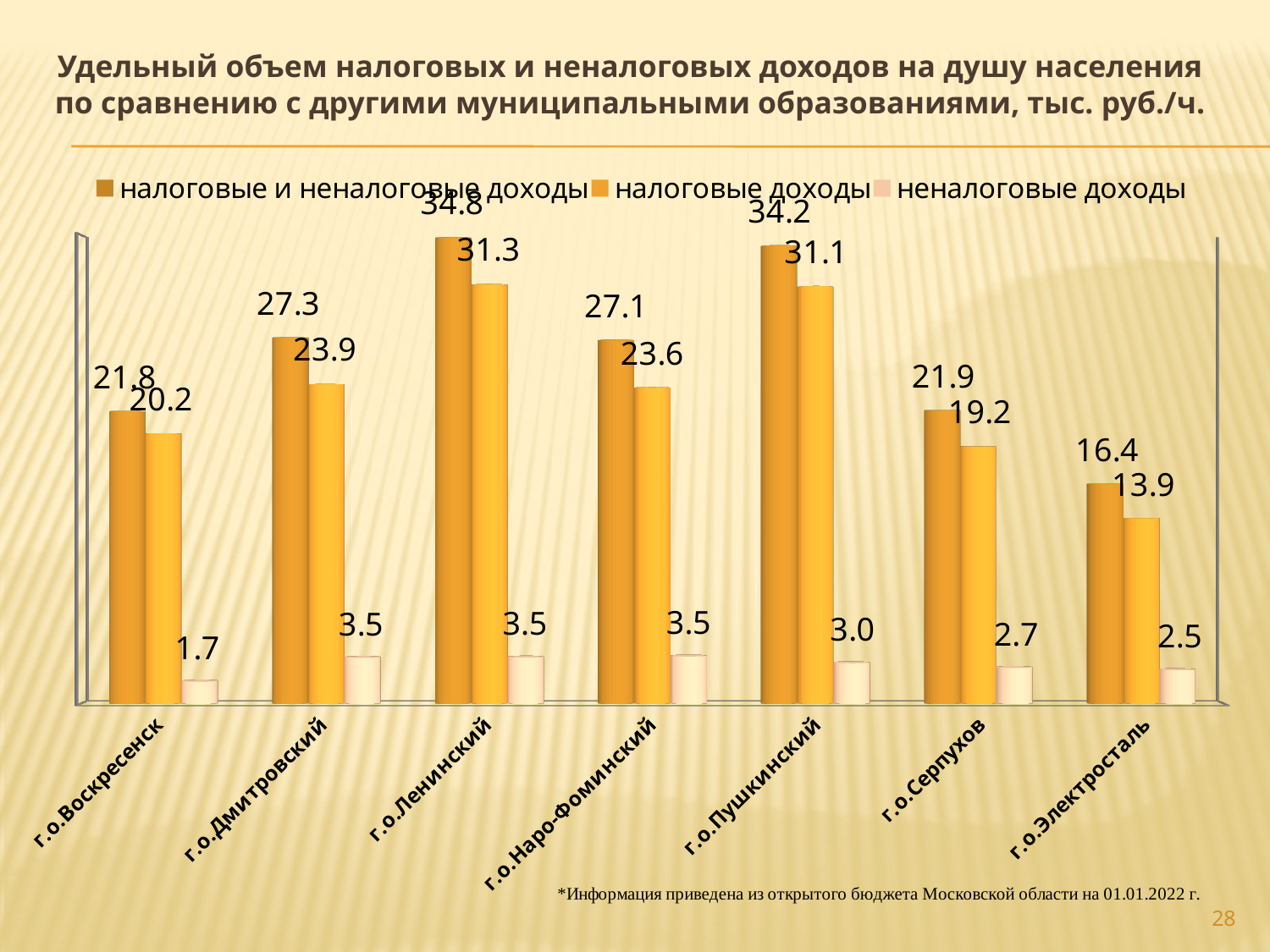
What is the value of налоговые доходы for г.о.Серпухов? 19.2 What kind of chart is shown on the slide? bar chart How many series does the legend list? 3 What is the value of налоговые и неналоговые доходы for г.о.Ленинский? 34.8 What is the value of неналоговые доходы for г.о.Электросталь? 2.5 What is the third series listed in the legend? неналоговые доходы What is the value of неналоговые доходы for г.о.Воскресенск? 1.7 Which is larger: налоговые доходы for г.о.Дмитровский or for г.о.Наро-Фоминский? г.о.Дмитровский How many municipalities are shown on the x axis? 7 Which municipality has the highest value of налоговые доходы? г.о.Ленинский Which municipality has the lowest value of налоговые и неналоговые доходы? г.о.Электросталь What is the difference between налоговые и неналоговые доходы and налоговые доходы for г.о.Пушкинский? 3.1